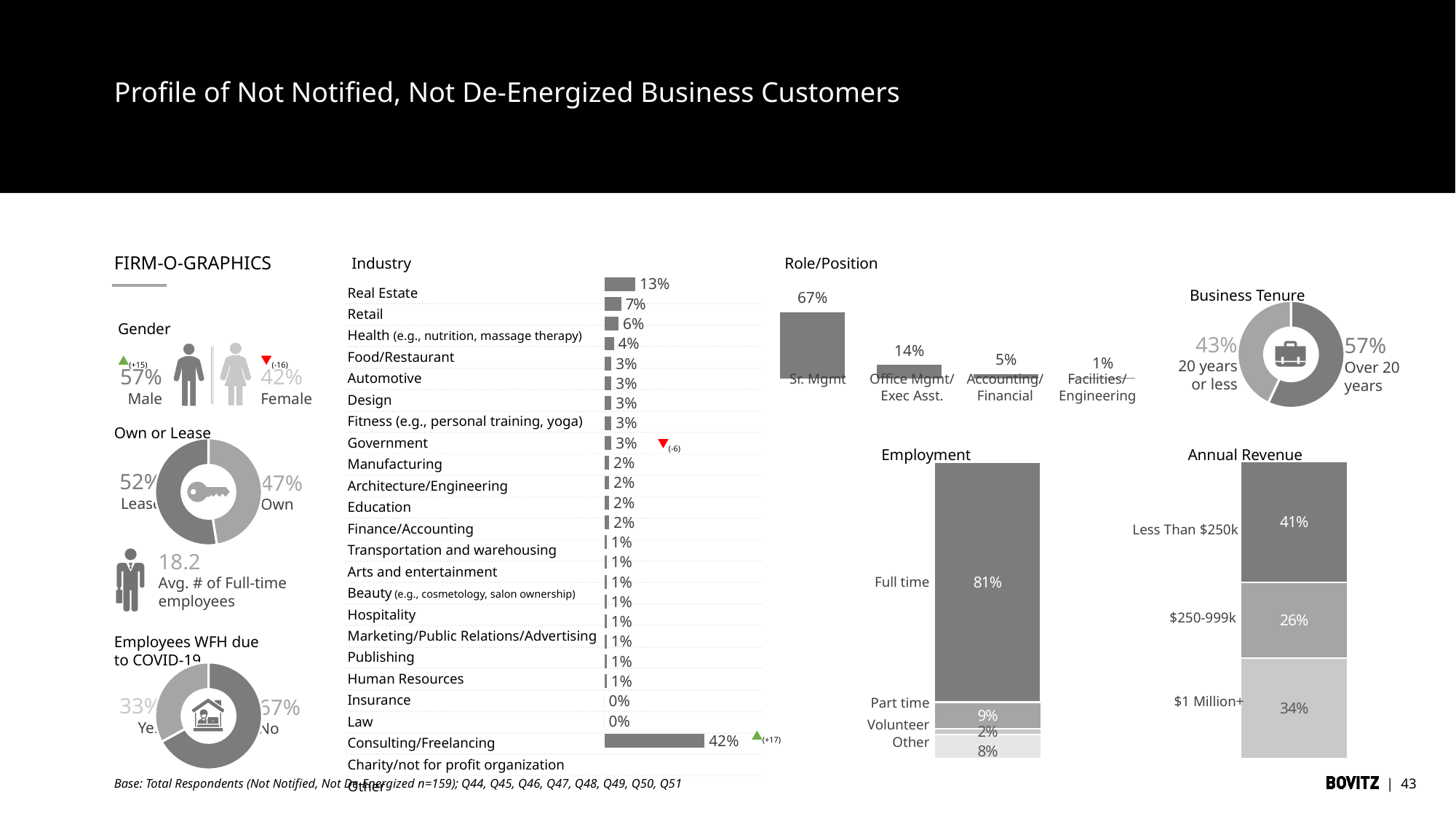
In the Employment chart, which is larger, Part time or Other? Part time In the Employment chart, what is the value for Full time? 81% In the Employment chart, what is the total of all four segments? 100% What kind of chart is the Industry chart? Bar chart In the Industry chart, what is the value for Real Estate? 13% In the Role/Position chart, what is the value for Sr. Mgmt? 67% In the Role/Position chart, what is the difference between Sr. Mgmt and Office Mgmt/Exec Asst.? 53% In the Annual Revenue chart, what is the value for $250-999k? 26% In the Role/Position chart, which role has the lowest value? Facilities/Engineering In the Role/Position chart, how many roles are shown? 4 In the Annual Revenue chart, which revenue band has the highest share? Less Than $250k In the Business Tenure donut chart, what share is Over 20 years? 57%